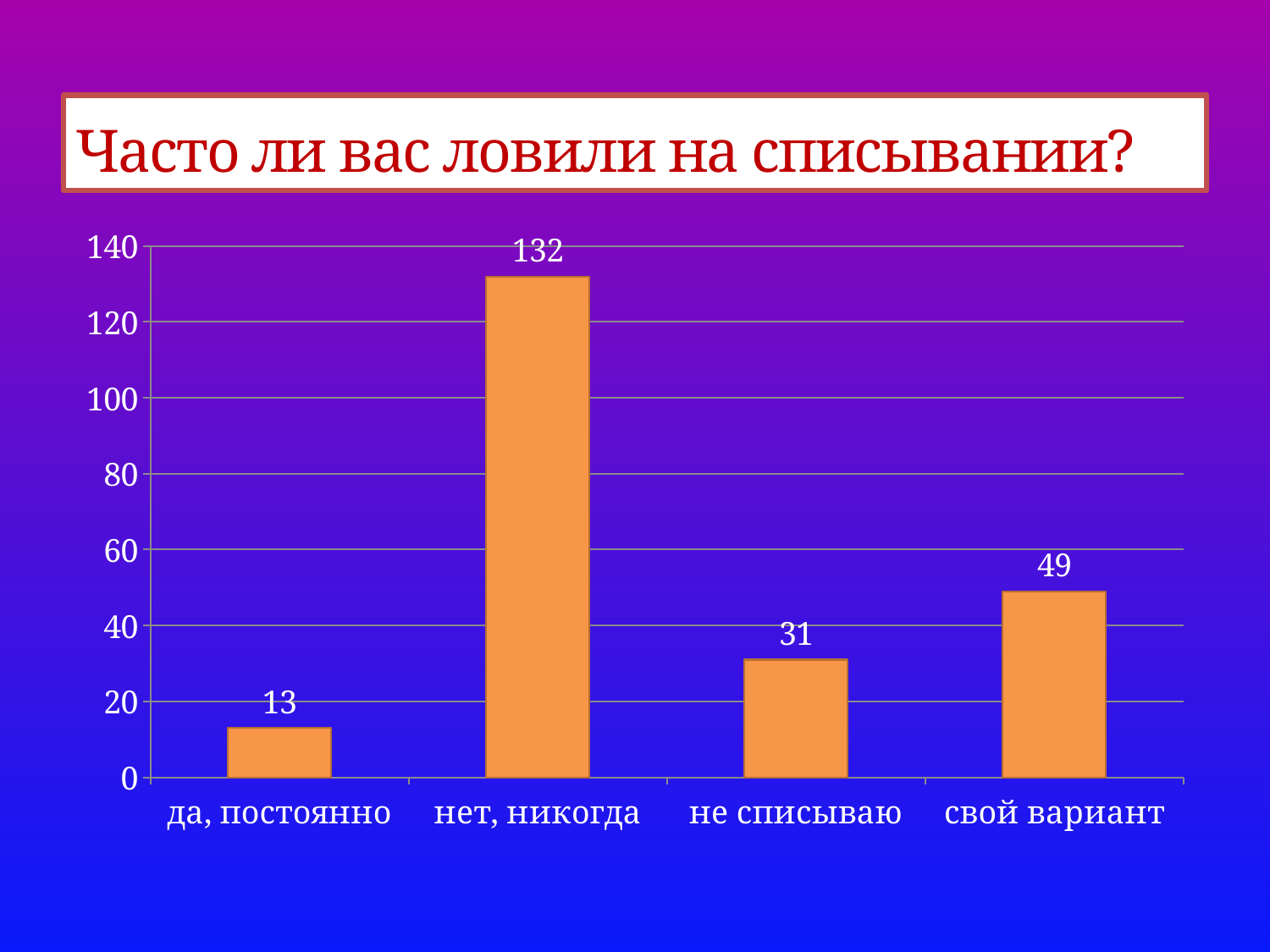
Is the value for "не списываю" greater or less than 40? less Which category has the highest value? нет, никогда What kind of chart is shown on the slide? bar chart What is the difference between the values for "нет, никогда" and "свой вариант"? 83 Which category has the lowest value? да, постоянно What is the title of the slide? Часто ли вас ловили на списывании? What is the value for "не списываю"? 31 What is the value for "нет, никогда"? 132 What is the value for "свой вариант"? 49 Which is larger, the value for "свой вариант" or the value for "не списываю"? свой вариант How many categories are shown on the x axis? 4 What is the value for "да, постоянно"? 13